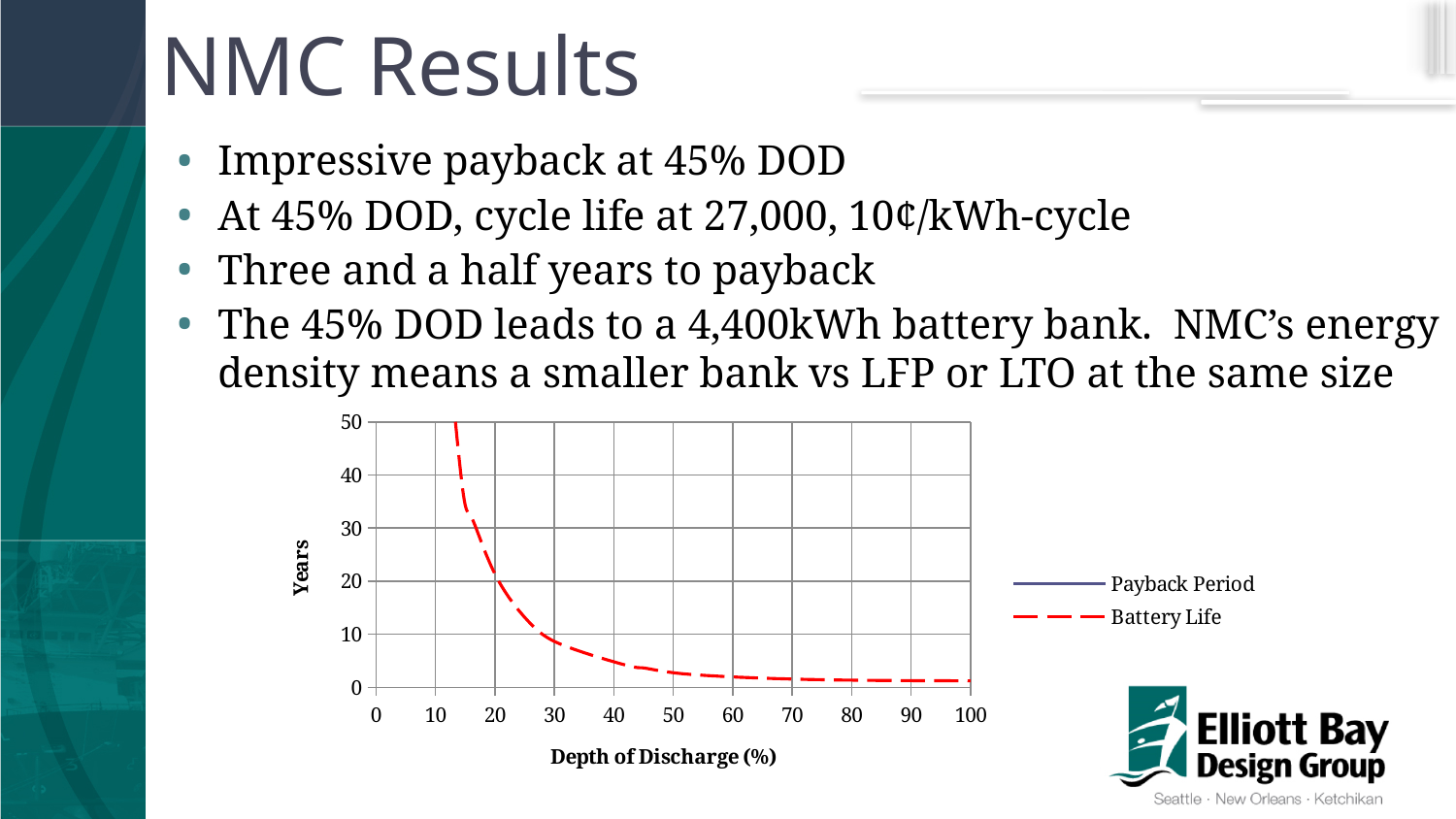
What kind of chart is shown on the slide? line chart What are the two series named in the chart's legend? Payback Period and Battery Life Which is larger, the Battery Life value at 20% Depth of Discharge or at 50% Depth of Discharge? 20% Depth of Discharge Is the Battery Life value at 15% Depth of Discharge greater or less than 30 years? greater What is the label of the chart's x axis? Depth of Discharge (%) What is the label of the chart's y axis? Years Is the Battery Life value at 100% Depth of Discharge greater or less than 10 years? less Is the Battery Life value at 40% Depth of Discharge greater or less than 10 years? less Does the Battery Life curve rise or fall as Depth of Discharge increases? fall How many series does the chart's legend list? 2